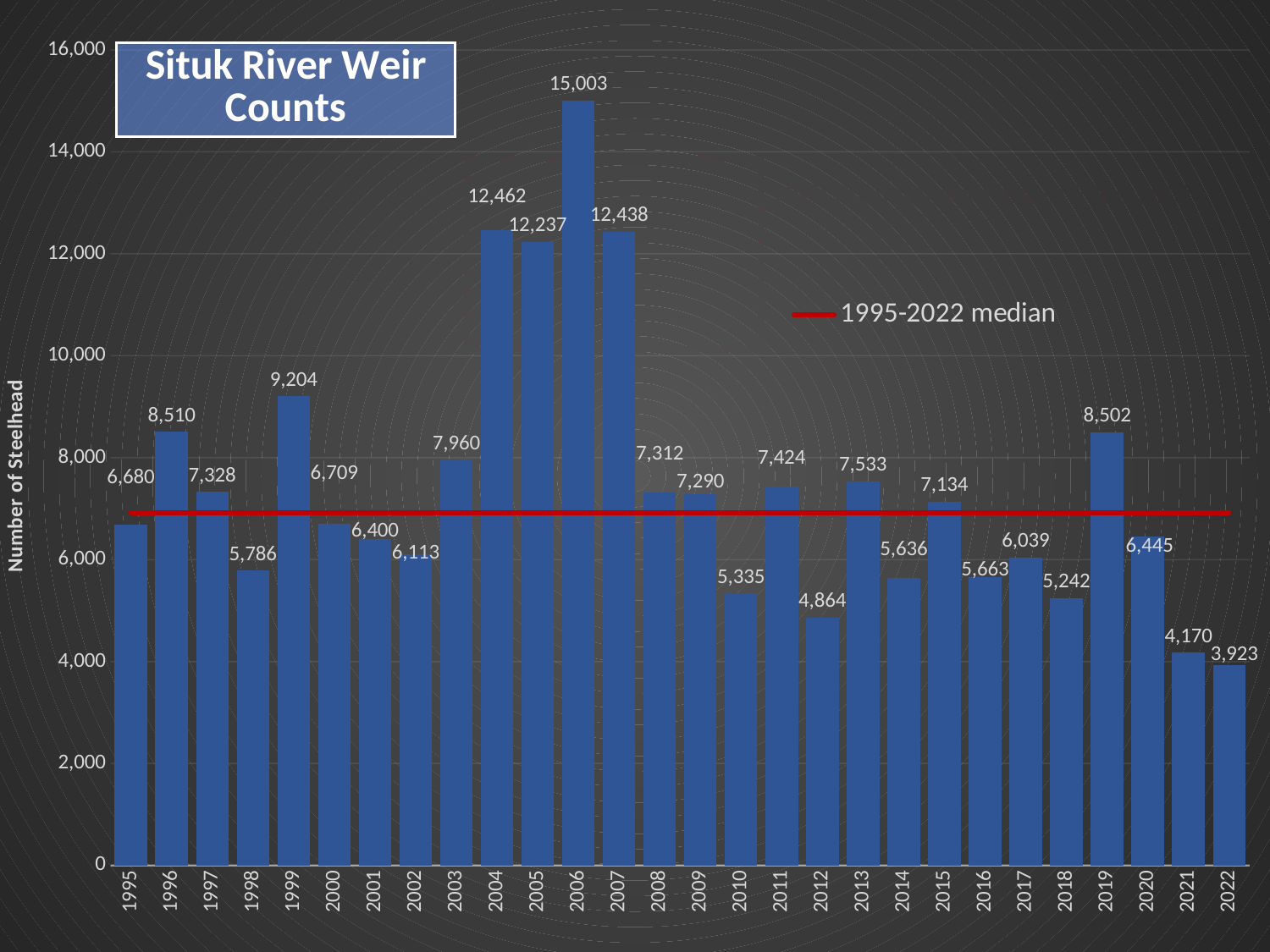
Which year has the lowest weir count? 2022 What is the difference between the weir counts for 2019 and 2020? 2,057 What does the red horizontal line represent according to the legend? 1995-2022 median What kind of chart is this? bar chart How many years are shown on the x axis? 28 What is the difference between the weir counts for 2006 and 2004? 2,541 What is the weir count for 1999? 9,204 Which year has a larger weir count, 1996 or 2019? 1996 What is the weir count for 2006? 15,003 Which year has the highest weir count? 2006 Is the weir count for 2012 greater or less than 6,000? less What is the weir count for 2022? 3,923